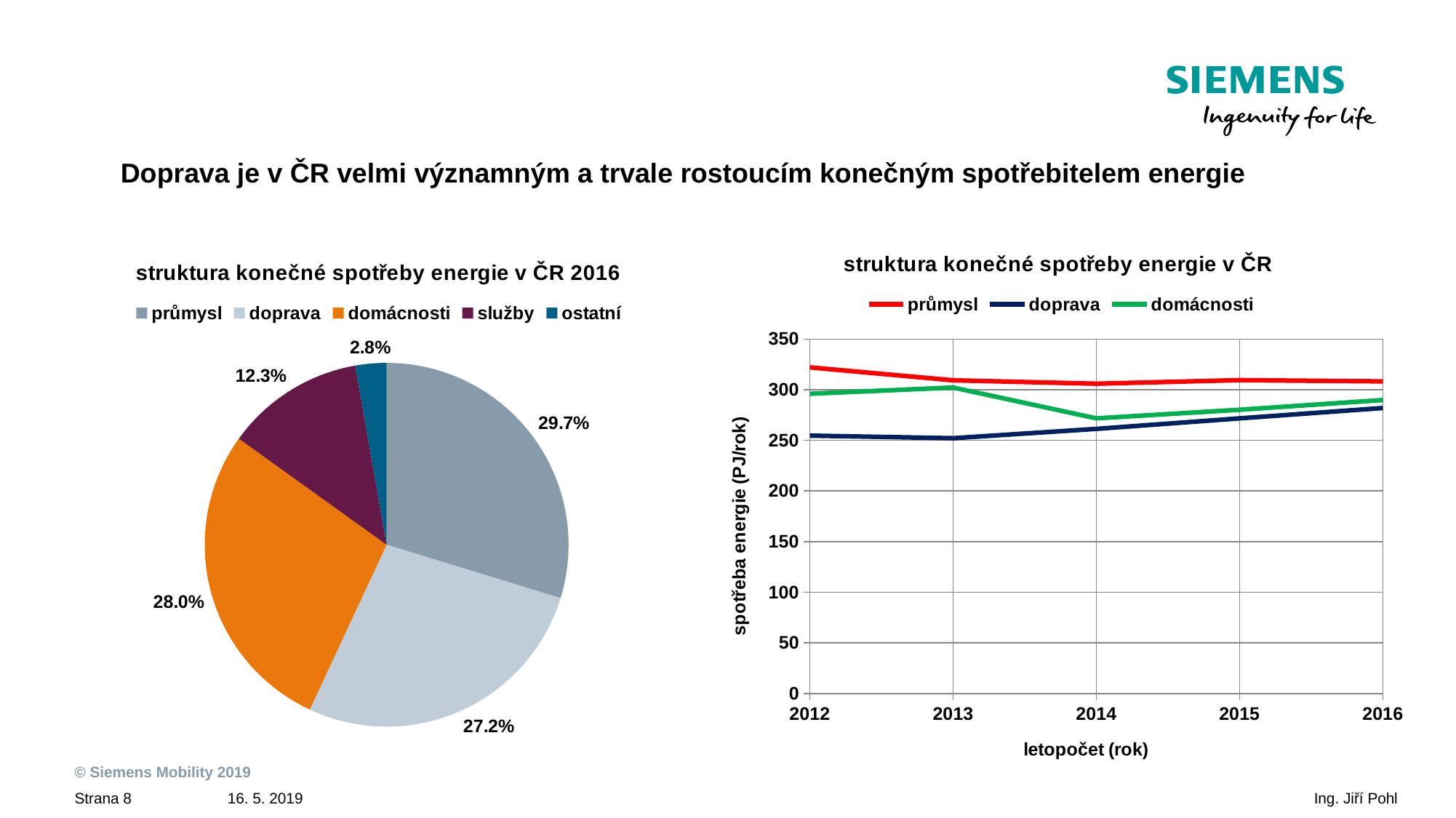
In the line chart on the right, does the doprava series rise or fall between 2013 and 2016? rise What kind of chart is the chart on the right, 'struktura konečné spotřeby energie v ČR'? line chart In the pie chart 'struktura konečné spotřeby energie v ČR 2016', what share does doprava have? 27.2% In the pie chart on the left, what is the difference in percentage points between the shares of průmysl and doprava? 2.5 How many series does the legend of the line chart on the right list? 3 In the pie chart on the left, which has the larger share, domácnosti or doprava? domácnosti In the pie chart 'struktura konečné spotřeby energie v ČR 2016', what share does služby have? 12.3% In the pie chart on the left, which category has the largest share? průmysl In the line chart on the right, is the value for průmysl in 2012 greater or less than 300? greater In the pie chart on the left, which category has the smallest share? ostatní In the line chart on the right, is the value for domácnosti in 2014 greater or less than 300? less How many slices does the pie chart on the left have? 5